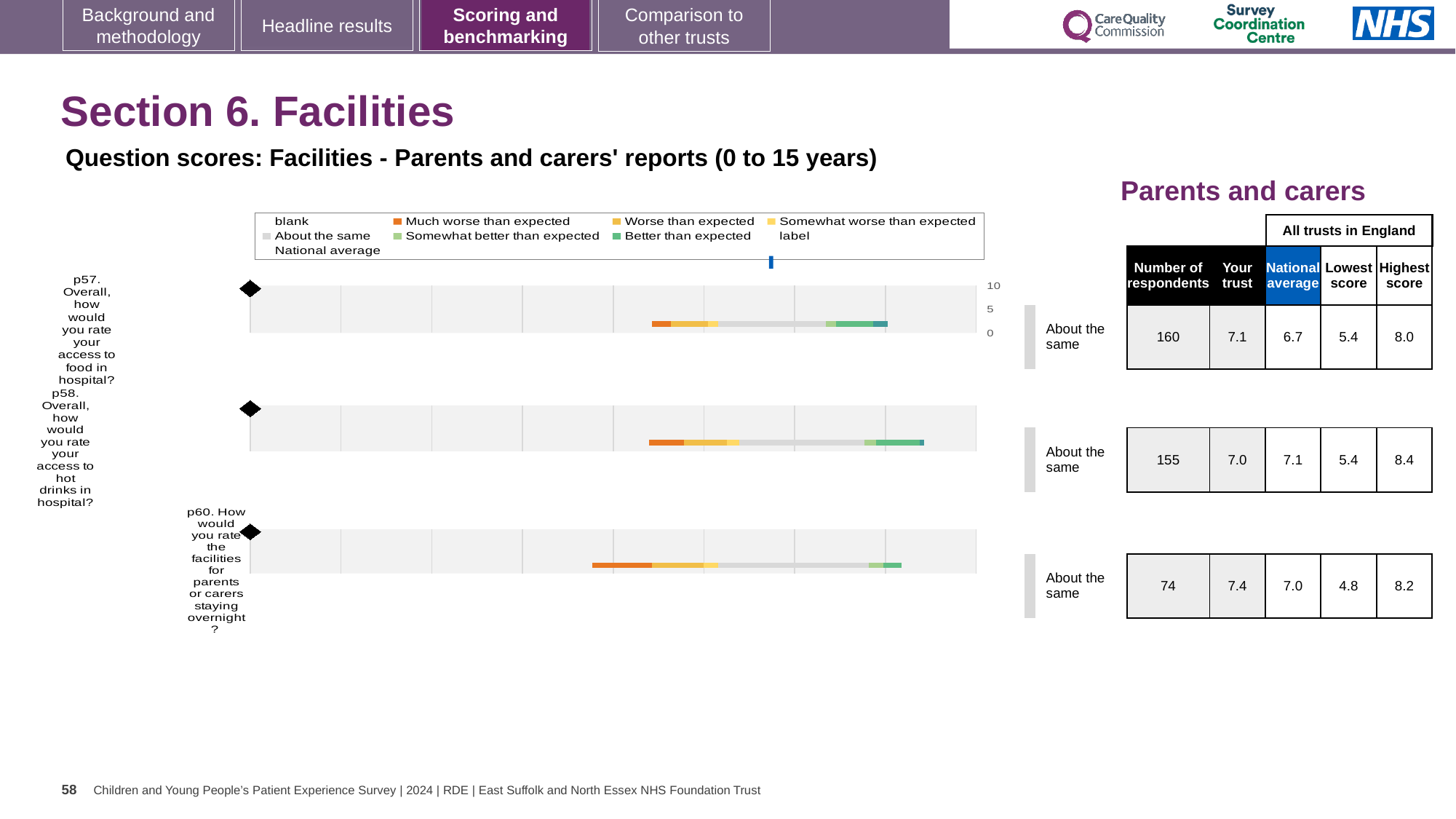
Which question has the lowest 'Lowest score' among all trusts in England? p60 What colour represents 'Much worse than expected' in the chart legend? Orange For p57, which is larger: the 'Your trust' score or the national average? Your trust What kind of chart is used to show the question scores for p57, p58 and p60? Bar chart What is the highest score across all trusts in England for p58? 8.4 What benchmark category is shown for all three questions on the slide? About the same How many questions (chart rows) are plotted on the slide? 3 What is the national average score for p58 (access to hot drinks in hospital)? 7.1 For p57, what is the difference between the highest score and the lowest score across all trusts in England? 2.6 How many respondents answered p60 (facilities for parents or carers staying overnight)? 74 Which question has the highest 'Your trust' score? p60 What is the 'Your trust' score for p57 (access to food in hospital)? 7.1